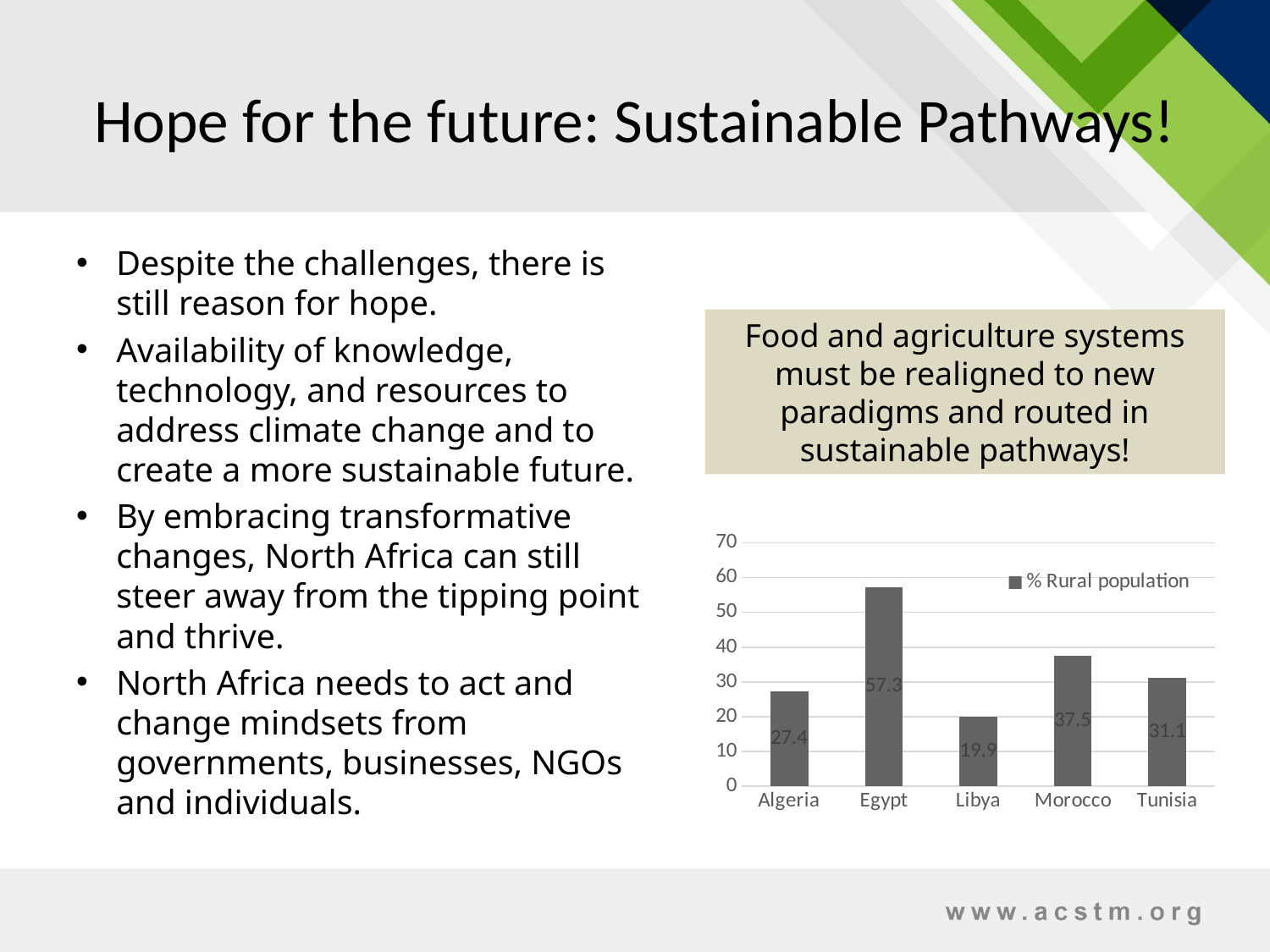
Which has a larger % Rural population, Tunisia or Algeria? Tunisia What is the % Rural population value for Egypt? 57.3 What is the % Rural population value for Libya? 19.9 Is the value for Egypt greater or less than 50? greater What is the difference in % Rural population between Morocco and Algeria? 10.1 What kind of chart is shown on the slide? bar chart Which country has the highest % Rural population? Egypt Which country has the lowest % Rural population? Libya What is the difference in % Rural population between Egypt and Libya? 37.4 How many series does the chart legend list? 1 How many countries are shown in the chart? 5 What is the % Rural population value for Morocco? 37.5